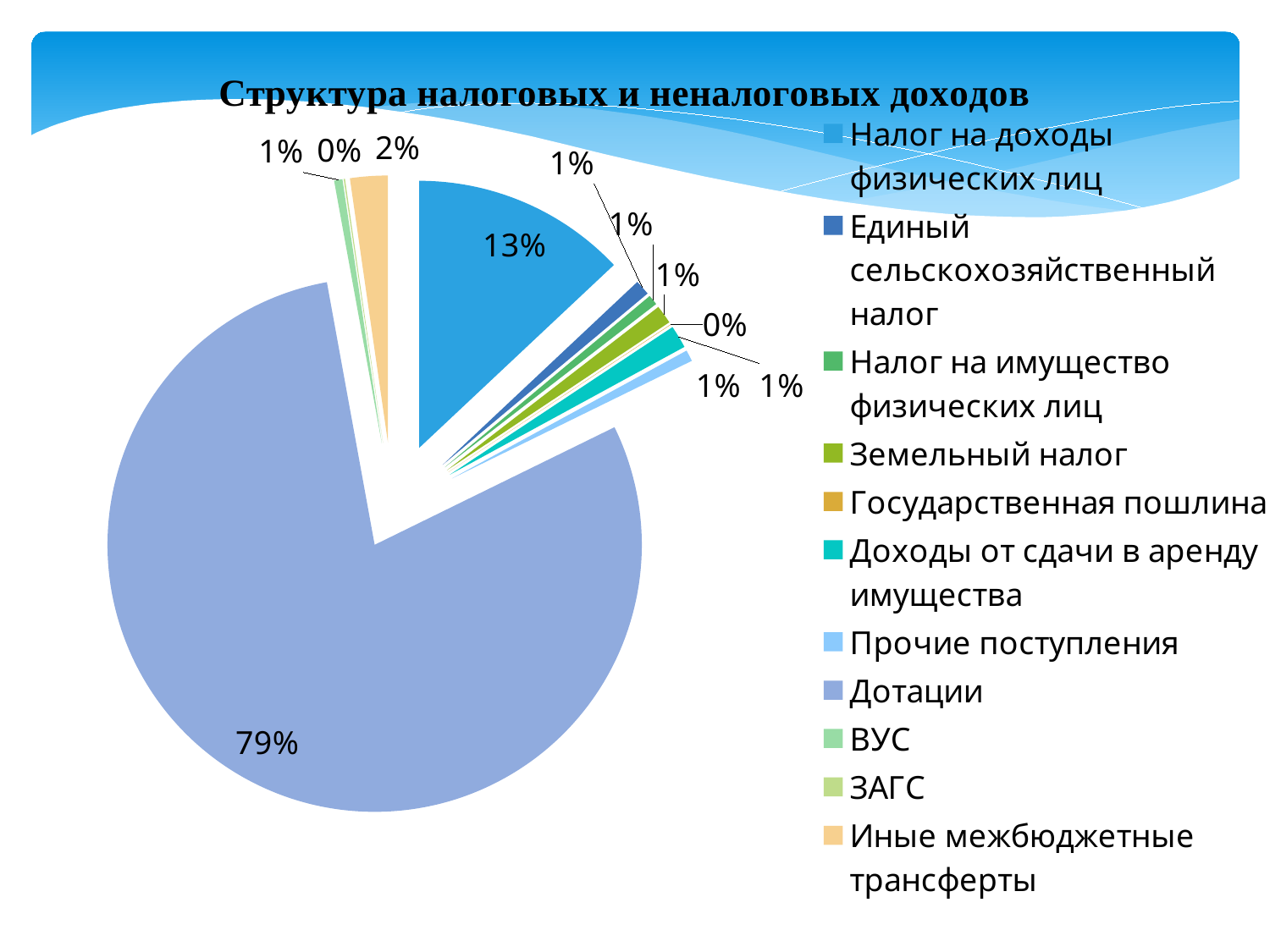
What is the difference in percentage points between the Налог на доходы физических лиц slice and the Иные межбюджетные трансферты slice? 11 Which is larger, the slice for Дотации or the slice for Налог на доходы физических лиц? Дотации What share of the pie does Дотации represent? 79% How many categories does the legend list? 11 Which legend entry is listed last in the legend? Иные межбюджетные трансферты What is the difference in percentage points between the Дотации slice and the Налог на доходы физических лиц slice? 66 What is the value shown for Налог на доходы физических лиц? 13% What type of chart is shown on the slide? pie chart Which category has the largest slice of the pie? Дотации Which is larger, the slice for Налог на доходы физических лиц or the slice for Иные межбюджетные трансферты? Налог на доходы физических лиц What is the title of the chart? Структура налоговых и неналоговых доходов What is the value shown for Иные межбюджетные трансферты? 2%